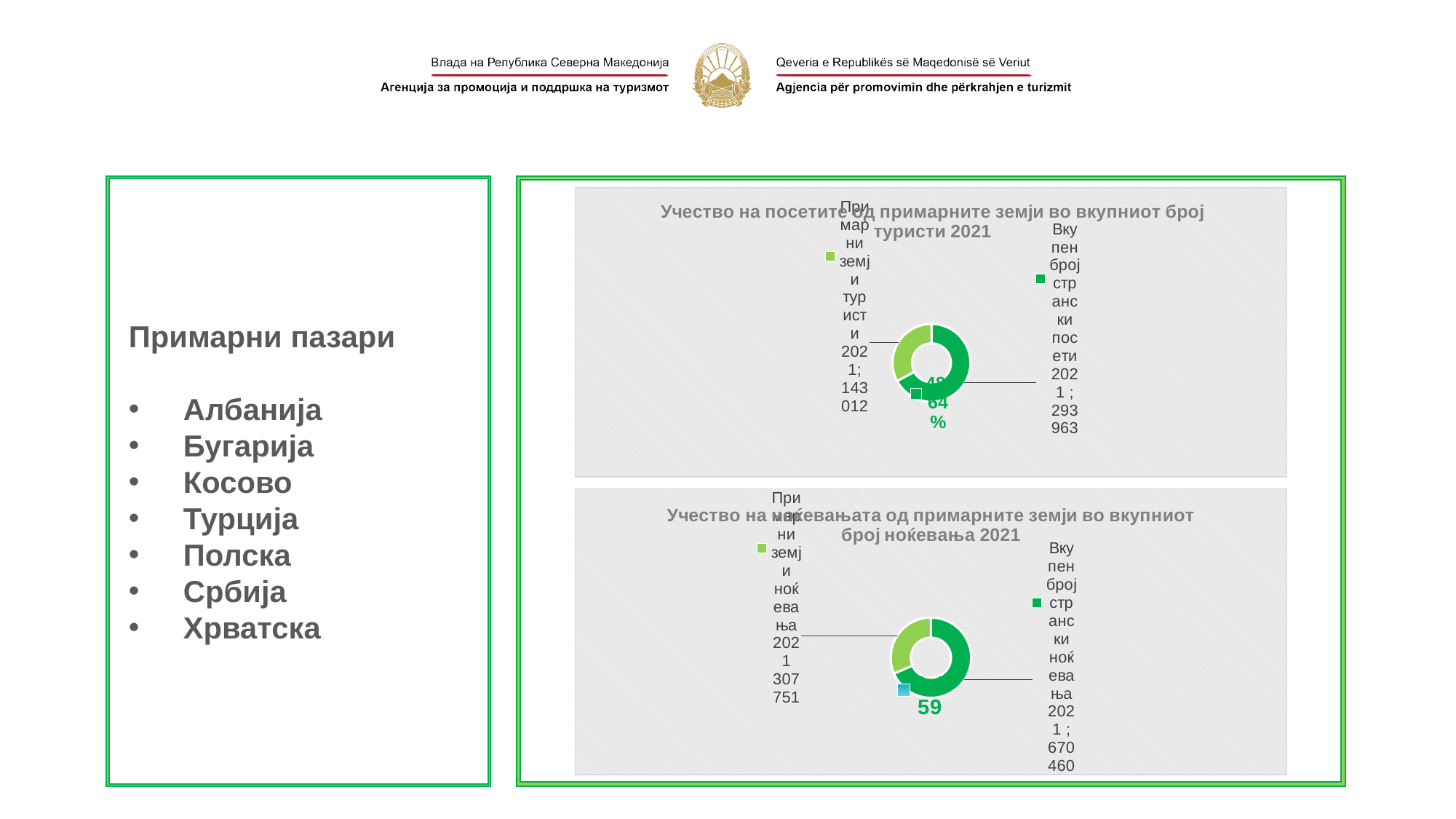
What is the title of the bottom chart? Учество на ноќевањата од примарните земји во вкупниот број ноќевања 2021 In the top chart, which slice is larger: 'Примарни земји туристи 2021' or 'Вкупен број странски посети 2021'? Вкупен број странски посети 2021 In the bottom chart, what value is shown for 'Вкупен број странски ноќевања 2021'? 670 460 How many slices does the bottom chart have? 3 In the bottom chart, 'Учество на ноќевањата од примарните земји во вкупниот број ноќевања 2021', what value is shown for 'Примарни земји ноќевања 2021'? 307 751 In the top chart, what is the difference between 'Вкупен број странски посети 2021' and 'Примарни земји туристи 2021'? 150 951 How many slices does the top chart have? 3 What kind of chart is the top chart, 'Учество на посетите од примарните земји во вкупниот број туристи 2021'? Doughnut (pie) chart In the top chart, what value is shown for 'Примарни земји туристи 2021'? 143 012 In the bottom chart, which slice is the largest? Вкупен број странски ноќевања 2021 In the bottom chart, what is the difference between 'Вкупен број странски ноќевања 2021' and 'Примарни земји ноќевања 2021'? 362 709 In the top chart, what value is shown for 'Вкупен број странски посети 2021'? 293 963